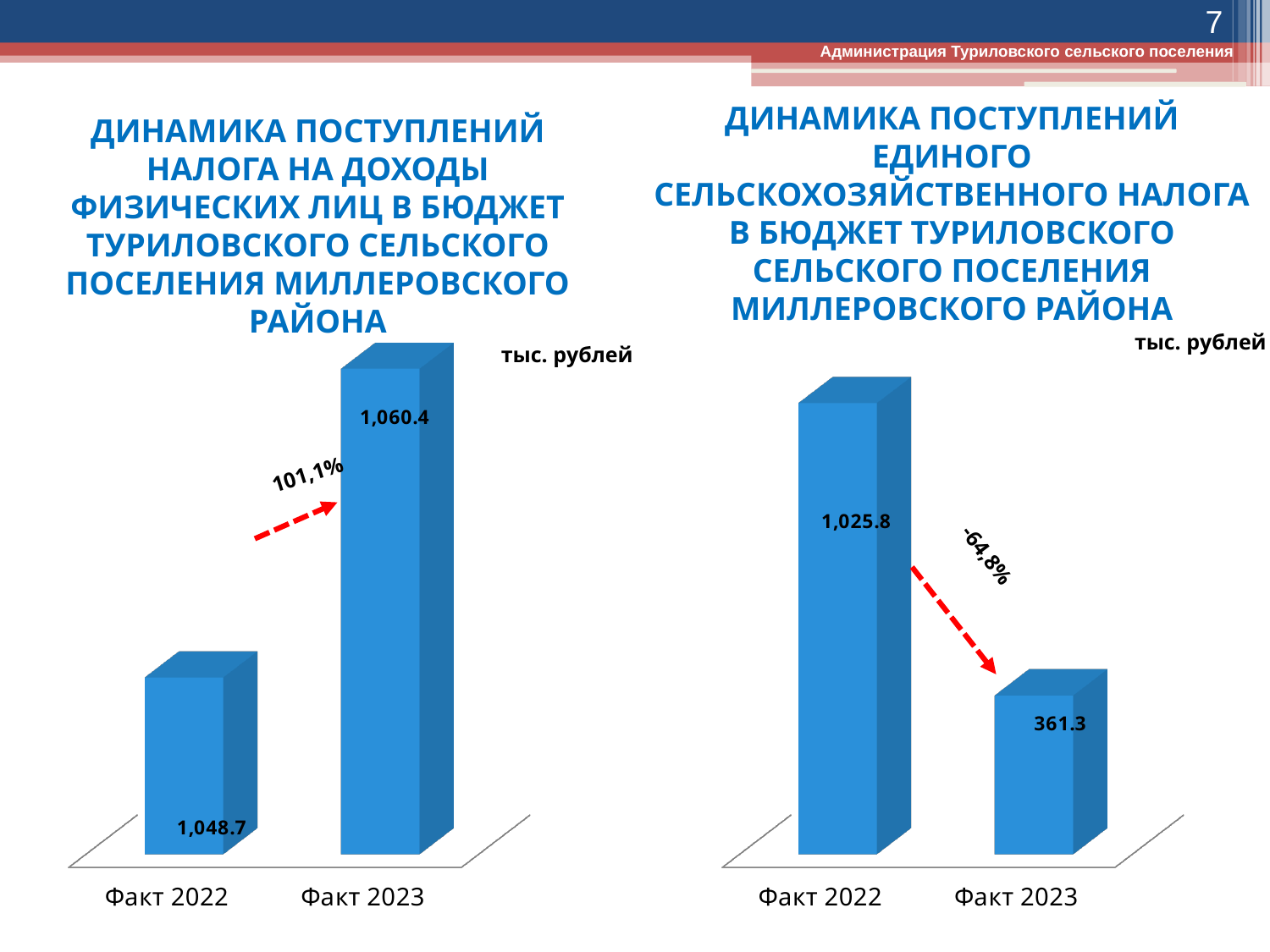
On the right chart (unified agricultural tax receipts), what is the value for Факт 2023? 361.3 What kind of chart is the right chart (unified agricultural tax receipts)? bar chart On the left chart (personal income tax receipts), what is the value for Факт 2023? 1,060.4 On the right chart (unified agricultural tax receipts), which category has the lowest value? Факт 2023 On the right chart (unified agricultural tax receipts), what is the difference between the Факт 2022 and Факт 2023 values? 664.5 How many categories are shown on the left chart (personal income tax receipts)? 2 On the left chart (personal income tax receipts), what is the difference between the Факт 2023 and Факт 2022 values? 11.7 What percentage change is annotated on the right chart (unified agricultural tax receipts)? -64,8% On the right chart (unified agricultural tax receipts), do the values rise or fall from Факт 2022 to Факт 2023? fall On the left chart (personal income tax receipts), which is larger: Факт 2022 or Факт 2023? Факт 2023 On the left chart (personal income tax receipts), what is the value for Факт 2022? 1,048.7 On the right chart (unified agricultural tax receipts), what is the value for Факт 2022? 1,025.8